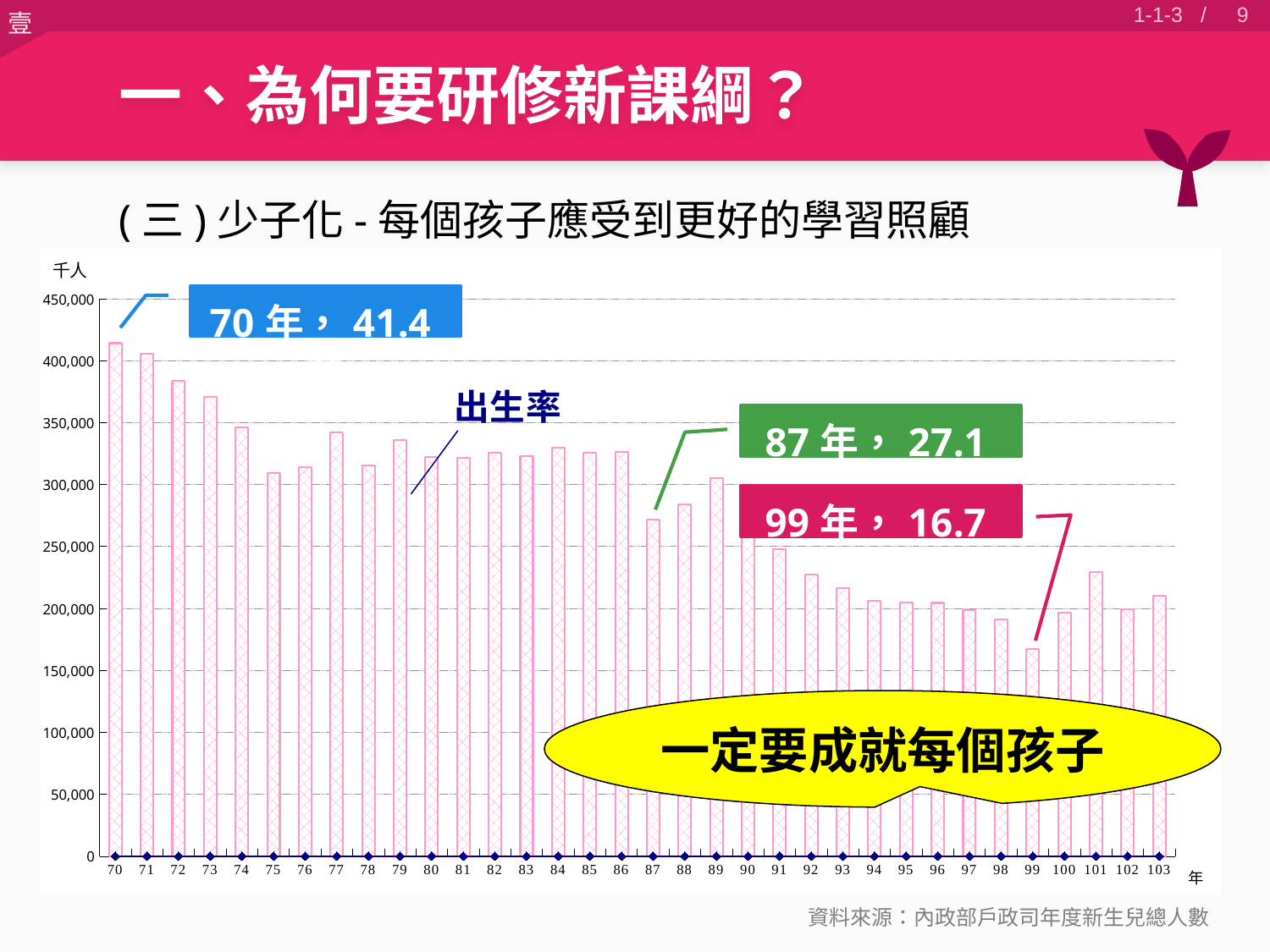
Is the value for year 99 greater or less than 200,000? less How many years (bars) are plotted on the x axis of the chart? 34 Which year has the lowest bar in the chart? 99 Which year has the highest bar in the chart? 70 Is the value for year 87 greater or less than 250,000? greater What unit is shown at the top of the y axis? 千人 Which is larger, the value for year 70 or the value for year 103? 70 Overall, do the bar values rise or fall from year 70 to year 103? fall What kind of chart is shown on the slide? bar chart Is the value for year 70 greater or less than 400,000? greater What birth rate (出生率) is shown in the callout for year 87? 27.1